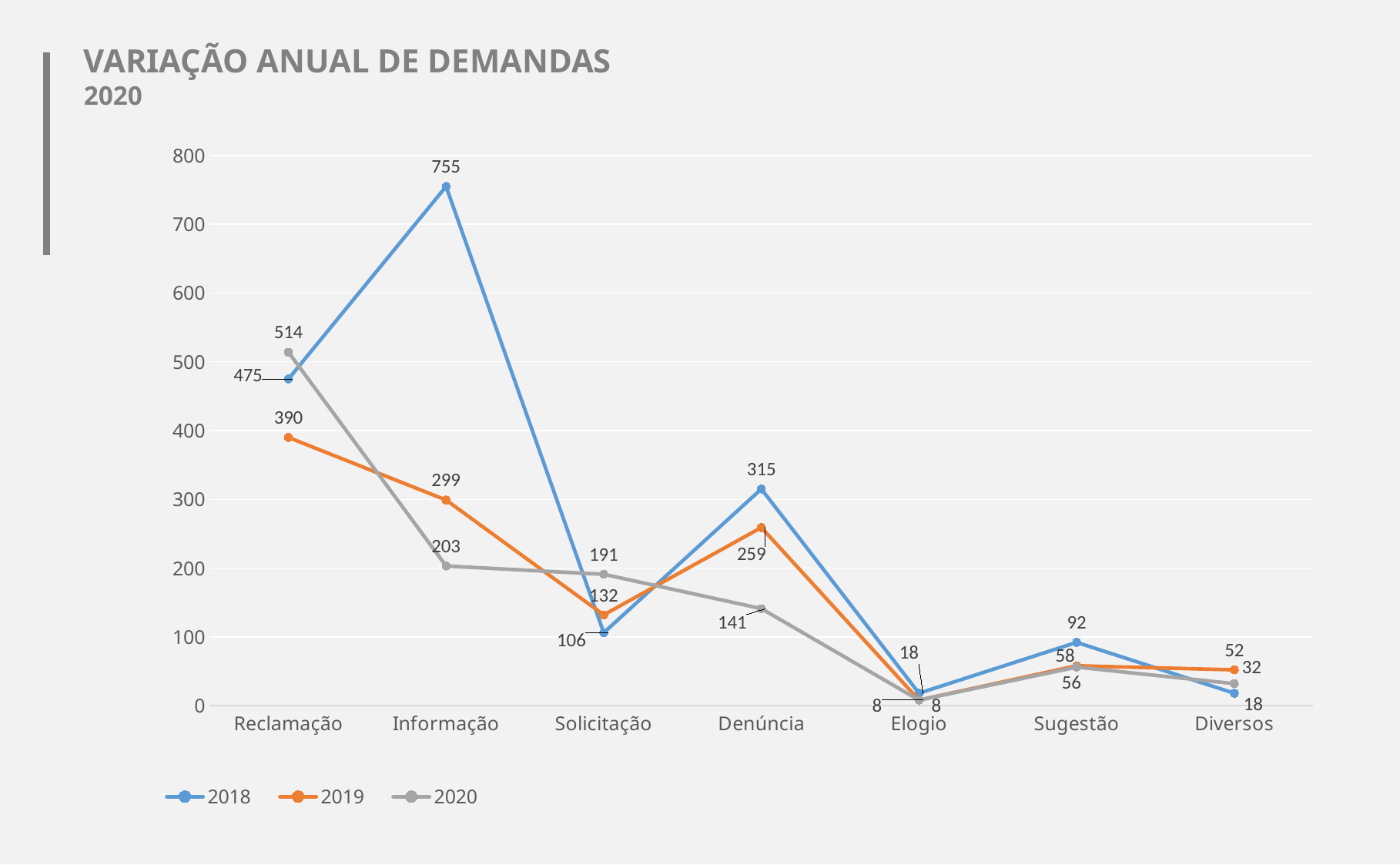
For Solicitação, which series has the larger value, 2019 or 2020? 2020 What is the value for Reclamação in the 2020 series? 514 Which category has the lowest value in the 2020 series? Elogio How many series does the legend list? 3 What is the value for Informação in the 2018 series? 755 How many categories are shown on the x axis? 7 Which category has the highest value in the 2018 series? Informação Does the 2020 series rise or fall from Reclamação to Elogio? Fall What is the value for Denúncia in the 2019 series? 259 What is the difference between the 2018 and 2019 values for Informação? 456 What kind of chart is shown on the slide? Line chart What is the title of the chart? VARIAÇÃO ANUAL DE DEMANDAS 2020